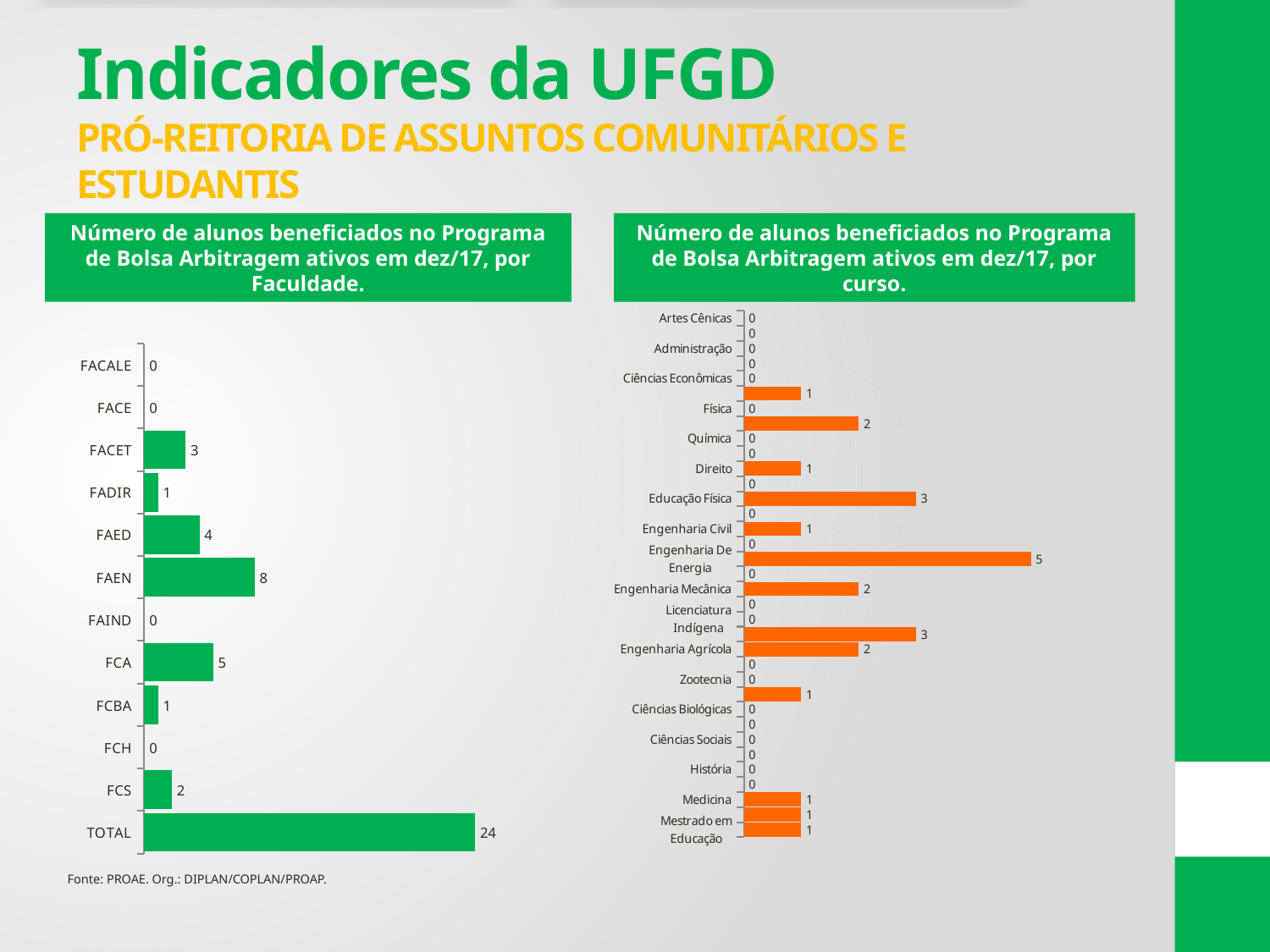
What kind of chart is the chart by Faculdade (left)? Bar chart In the chart by Faculdade (left), what is the difference between the values for FAEN and FCA? 3 In the chart by curso (right), what is the value for Engenharia Mecânica? 2 In the chart by Faculdade (left), excluding the TOTAL bar, which faculty has the highest value? FAEN In the chart by Faculdade (left), what is the value for FCA? 5 In the chart by curso (right), which is larger, the value for Educação Física or the value for Direito? Educação Física In the chart by Faculdade (left), how many categories are shown, including TOTAL? 12 In the chart by Faculdade (left), which is larger, the value for FACET or the value for FAED? FAED In the chart by curso (right), what is the value for Educação Física? 3 In the chart by Faculdade (left), what is the value shown for TOTAL? 24 In the chart by Faculdade (left), what is the value for FAEN? 8 What colour are the bars in the chart by curso (right)? Orange